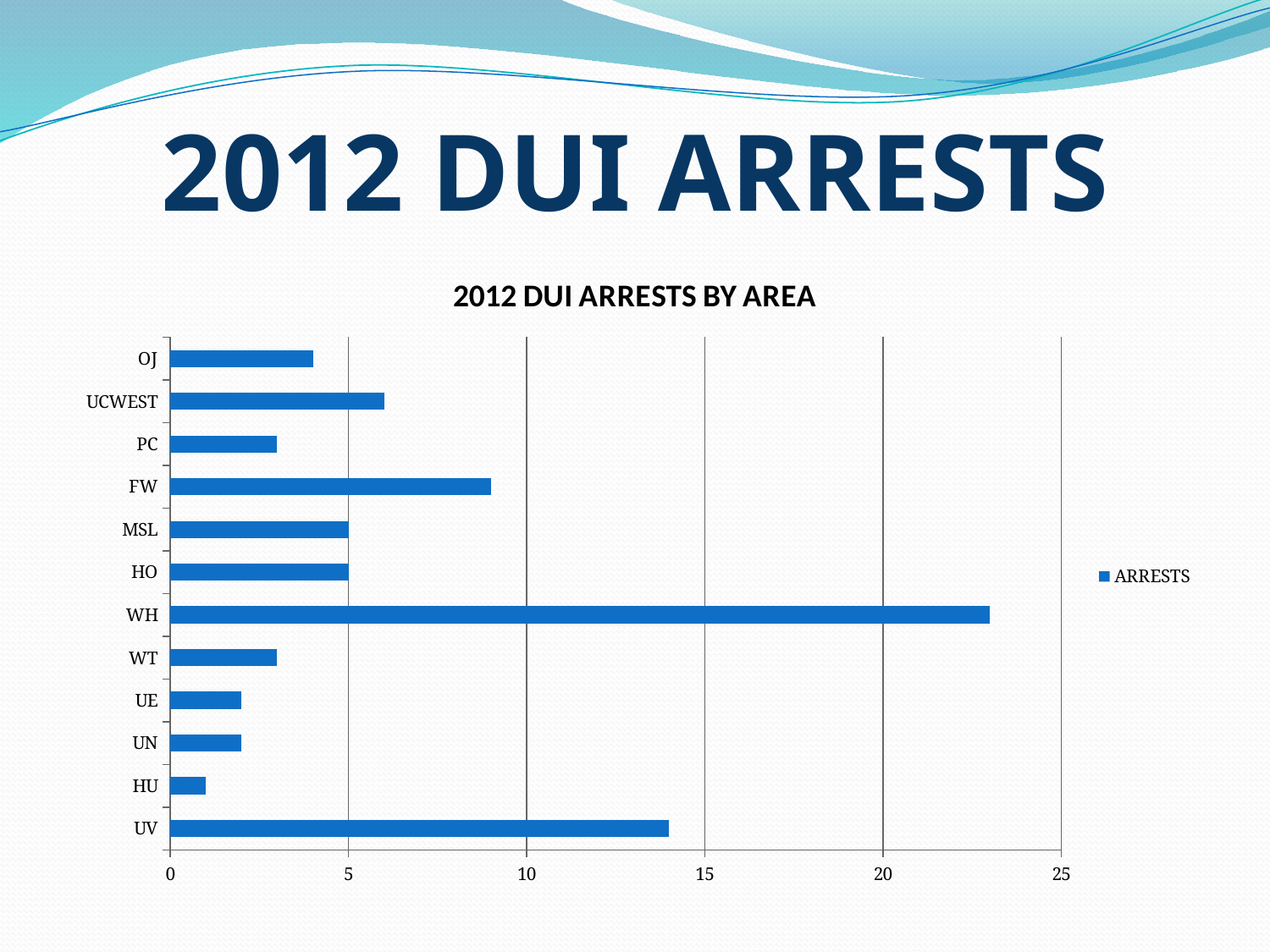
Is the value for OJ greater or less than 5? less Is the value for UV greater or less than 10? greater How many series does the legend list? 1 Is the value for WH greater or less than 20? greater Which area has the highest number of arrests? WH What kind of chart is shown on the slide? bar chart Which area has the lowest number of arrests? HU How many areas (categories) are shown in the chart? 12 Which has more arrests, UCWEST or PC? UCWEST Which has more arrests, UV or FW? UV What is the title of the chart? 2012 DUI ARRESTS BY AREA